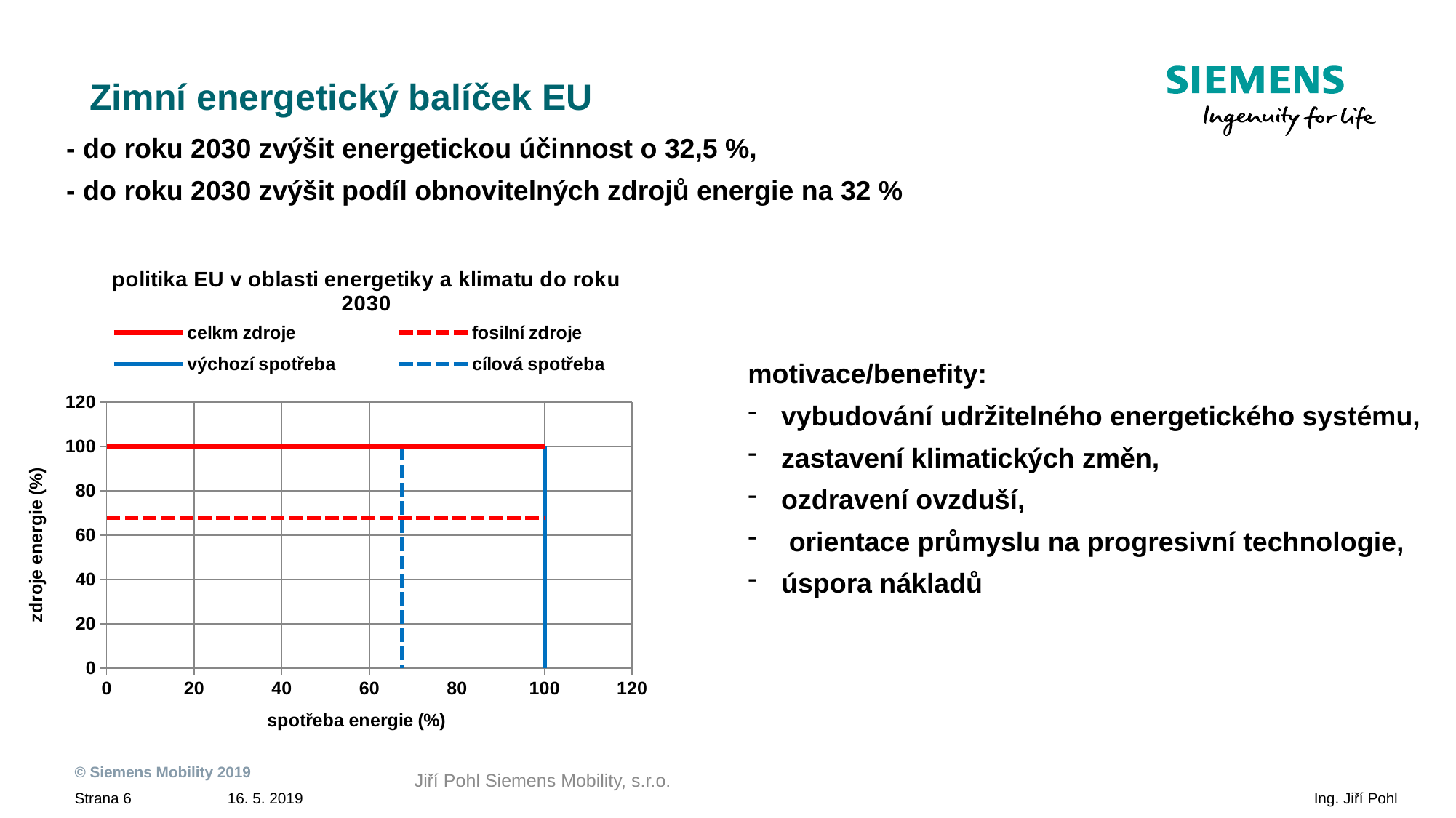
Is the x-axis value of the dashed blue 'cílová spotřeba' line greater or less than 80? less What is the title of the chart on the slide? politika EU v oblasti energetiky a klimatu do roku 2030 At what value on the y axis (zdroje energie) does the solid red 'celkm zdroje' line lie? 100 What kind of chart is shown on the slide? line chart Is the x-axis value of the dashed blue 'cílová spotřeba' line greater or less than 60? greater Is the y-axis value of the dashed red 'fosilní zdroje' line greater or less than 60? greater What is the label of the x axis of the chart? spotřeba energie (%) How many series does the chart legend list? 4 At what value on the x axis (spotřeba energie) does the solid blue 'výchozí spotřeba' line lie? 100 Which vertical line lies further right on the x axis, 'výchozí spotřeba' or 'cílová spotřeba'? výchozí spotřeba Which line lies higher on the y axis, 'celkm zdroje' or 'fosilní zdroje'? celkm zdroje